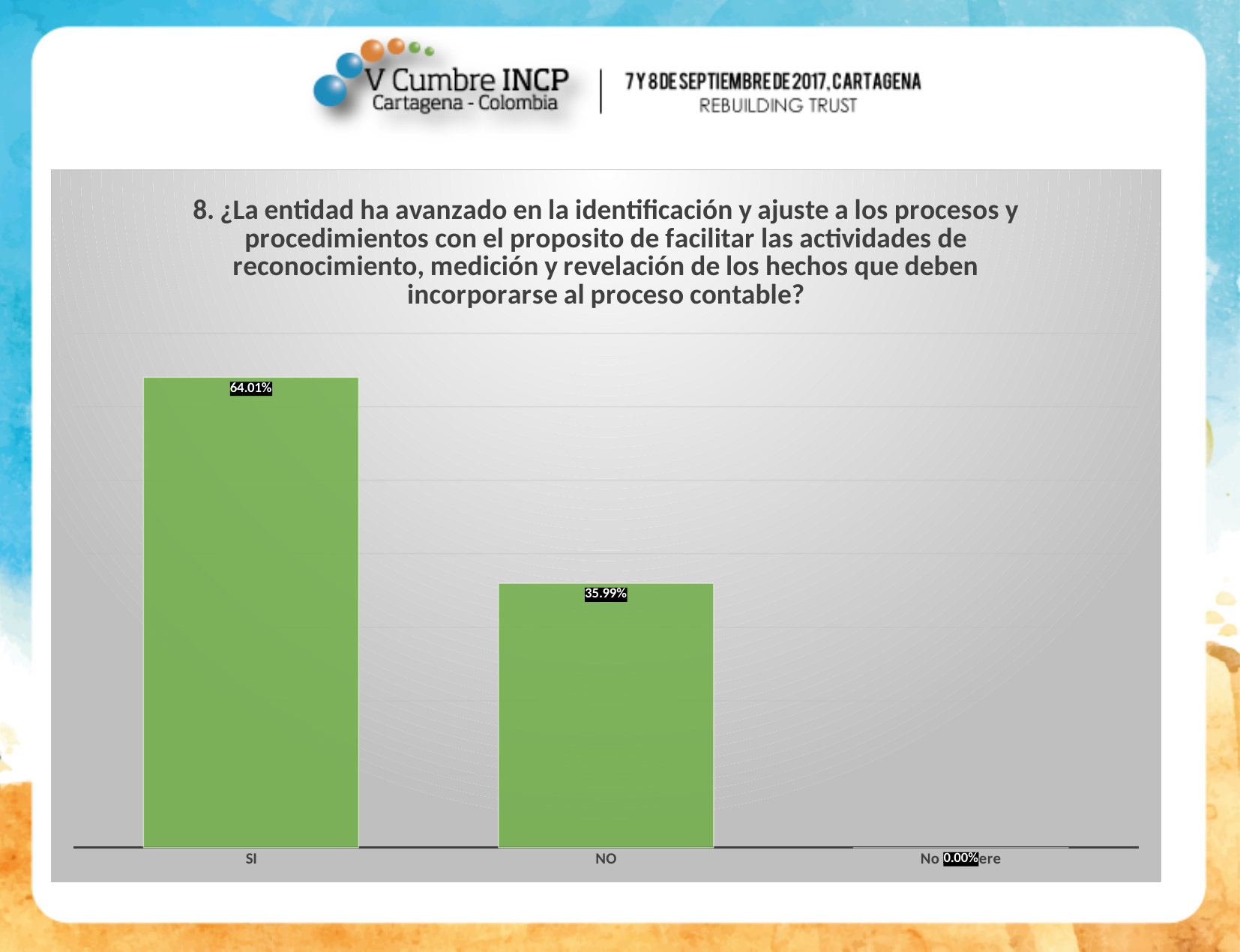
Which category has the highest value? SI What question number appears at the start of the chart title? 8 What is the value shown for the NO bar? 35.99% What is the difference between the SI value and the NO value? 28.02% What is the value shown for the SI bar? 64.01% What colour are the bars in the chart? Green What kind of chart is shown on the slide? Bar chart Do the bar values rise or fall from left to right along the x axis? Fall How many categories are shown on the x axis of the chart? 3 Which is larger, the value for SI or the value for NO? SI